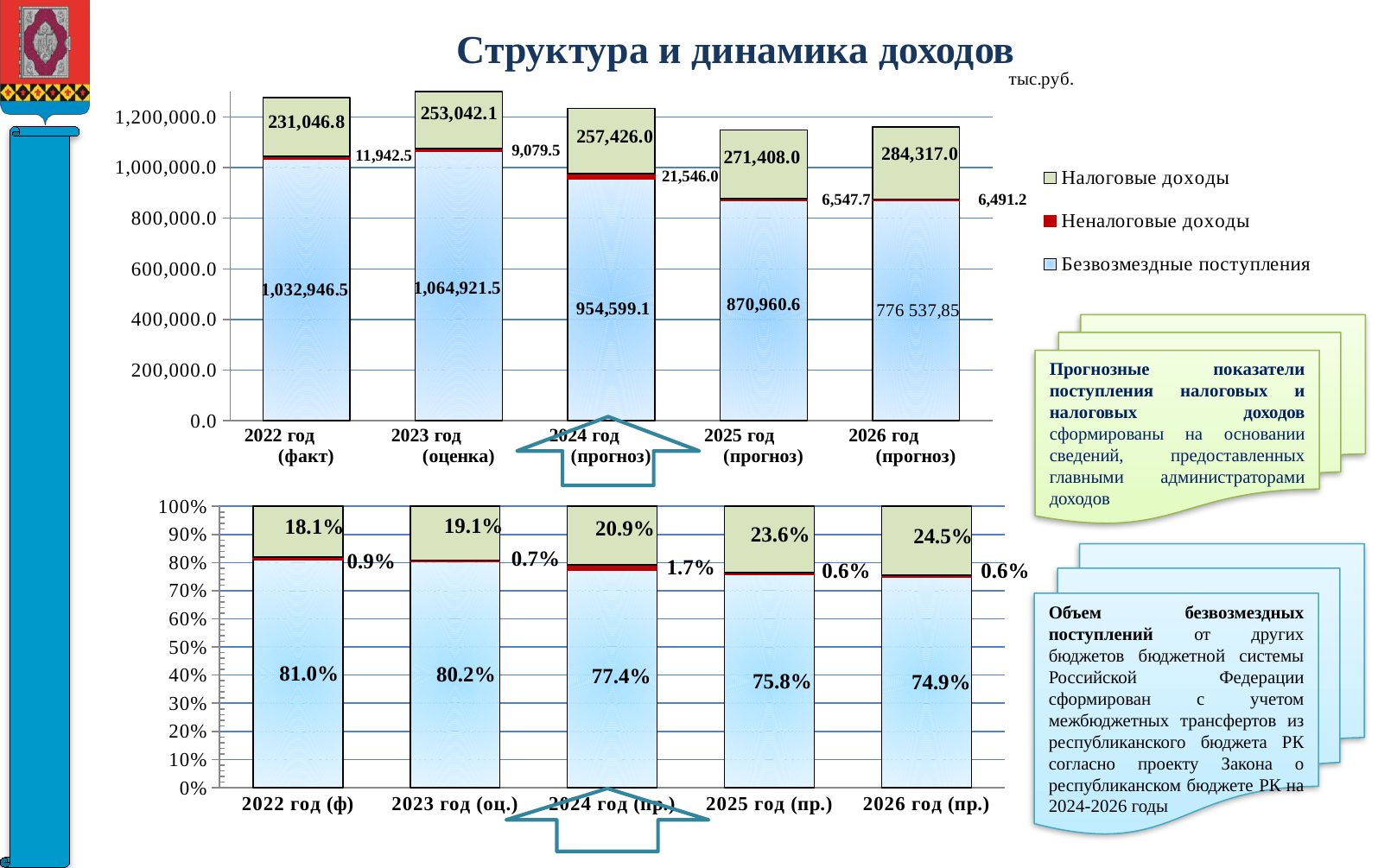
In the top chart, what is the value of Безвозмездные поступления for 2024 год (прогноз)? 954,599.1 In the top chart, which year has the lowest value of Неналоговые доходы? 2026 год (прогноз) In the bottom chart, what is the share of Налоговые доходы for 2024 год (пр.)? 20.9% In the top chart, what is the value of Неналоговые доходы for 2025 год (прогноз)? 6,547.7 In the top chart, what is the total of the stacked bar for 2022 год (факт)? 1,275,935.8 In the top chart, is the total of the stacked bar for 2025 год (прогноз) greater or less than 1,000,000.0? greater In the bottom chart, does the share of Безвозмездные поступления rise or fall from 2022 to 2026? fall In the top chart, what is the value of Налоговые доходы for 2022 год (факт)? 231,046.8 How many series does the legend list? 3 In the top chart, which year has the highest value of Безвозмездные поступления? 2023 год (оценка) In the top chart, what is the difference between Налоговые доходы in 2026 год (прогноз) and in 2022 год (факт)? 53,270.2 In the bottom chart, is the share of Безвозмездные поступления larger in 2022 год (ф) or in 2026 год (пр.)? 2022 год (ф)